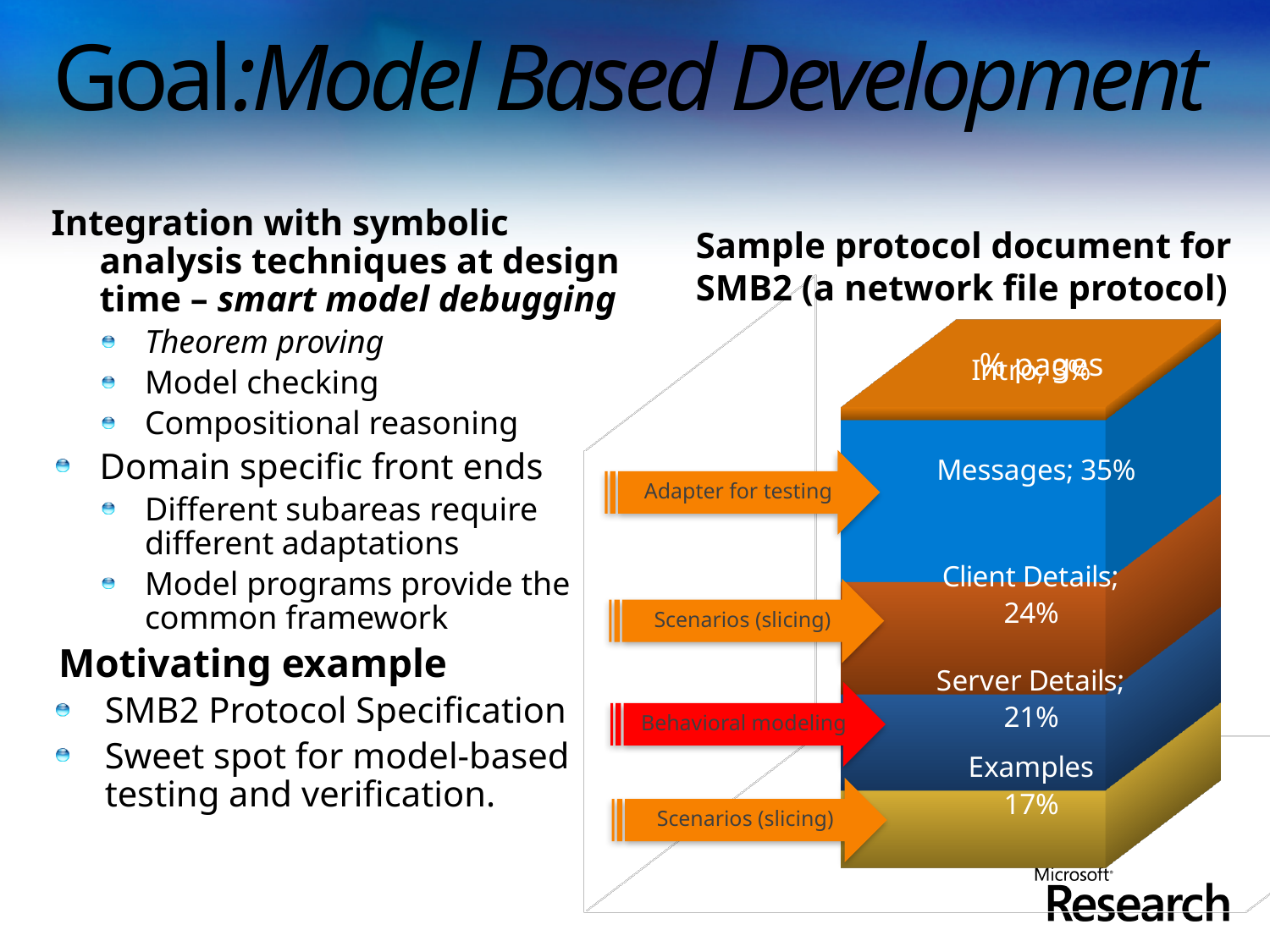
How many segments make up the stacked bar? 5 What percentage of pages is shown for Client Details? 24% What percentage of pages is shown for Examples? 17% What percentage of pages is shown for Server Details? 21% What is the difference in percentage points between Server Details and Examples? 4% What percentage of pages does the Messages segment account for? 35% What is the difference in percentage points between Messages and Client Details? 11% Which has a larger share of pages, Client Details or Server Details? Client Details Which segment of the stacked bar has the smallest share of pages? Intro Which segment of the stacked bar has the largest share of pages? Messages What is the title above the chart? Sample protocol document for SMB2 (a network file protocol) What kind of chart is shown on the right of the slide? Stacked bar chart